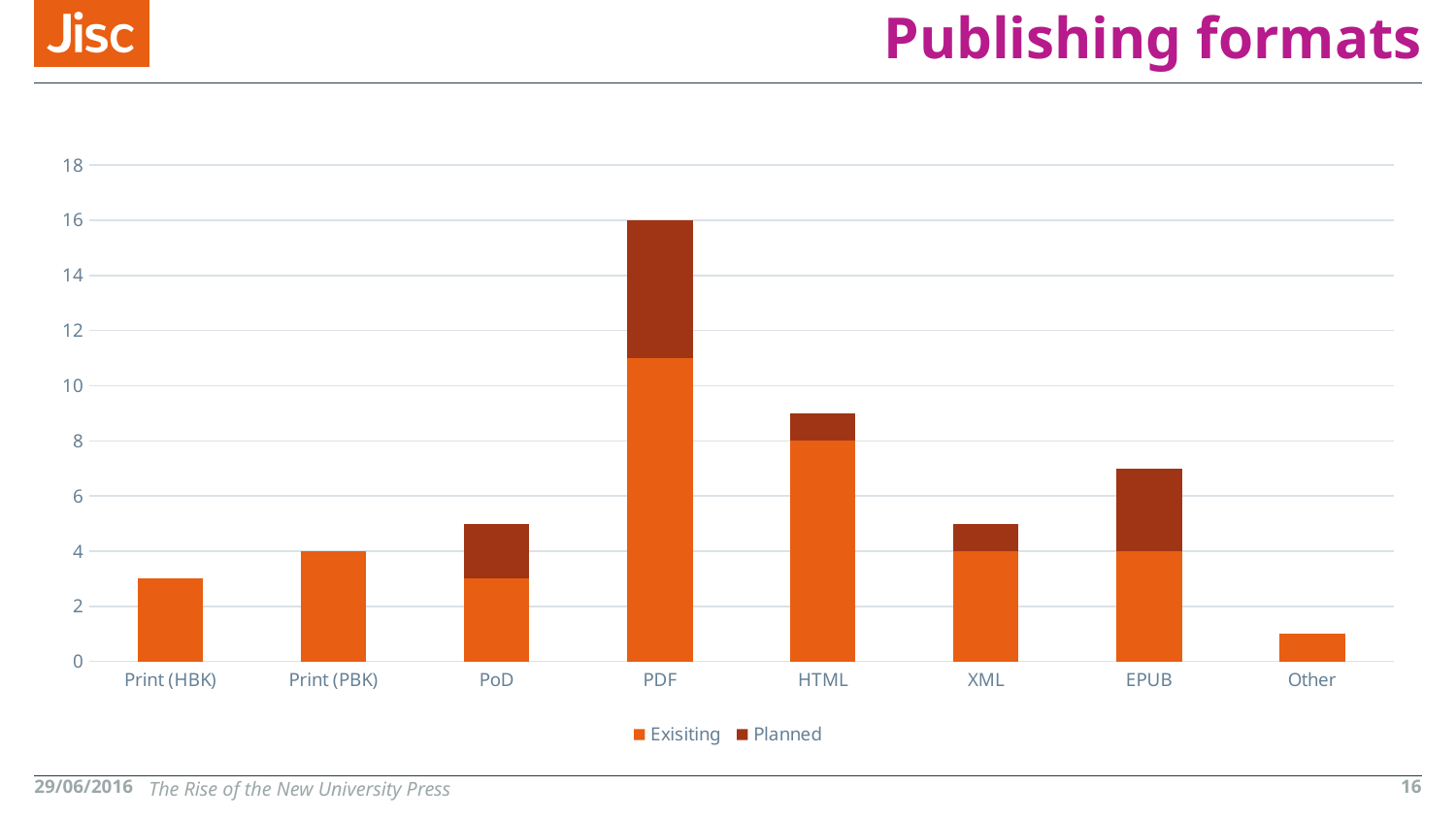
What is the total height of the stacked bar for PDF? 16 Which publishing format has the highest total bar? PDF How many series does the legend list? 2 Is the Exisiting value for PDF greater or less than 10? greater Which publishing format has the lowest total bar? Other What are the two entries listed in the legend? Exisiting and Planned How many publishing format categories are shown on the x axis? 8 Is the value for Print (HBK) greater or less than 4? less What is the Exisiting value for Print (PBK)? 4 What kind of chart is shown on the slide? bar chart Which has the larger total bar, HTML or XML? HTML What is the Exisiting value for HTML? 8